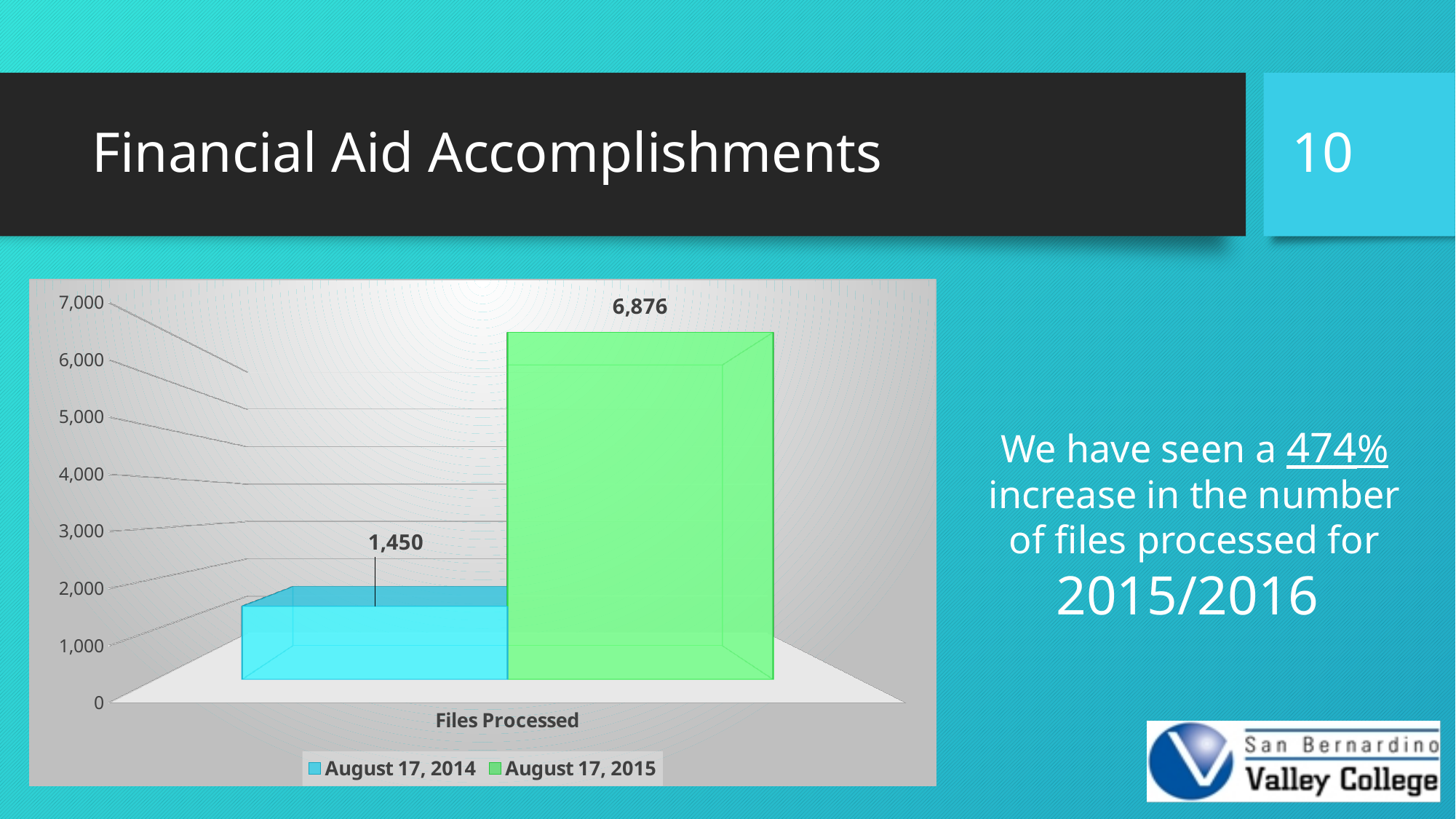
How many series does the legend list? 2 What kind of chart is shown on the slide? bar chart What is the value for August 17, 2014 in the Files Processed chart? 1,450 Is the value for August 17, 2015 greater or less than 6,000? greater What is the category label on the x axis of the chart? Files Processed Which series has the lower value for Files Processed? August 17, 2014 What is the value for August 17, 2015 in the Files Processed chart? 6,876 Is the value for August 17, 2014 greater or less than 2,000? less Which series has the higher value for Files Processed? August 17, 2015 What colour is the bar for August 17, 2015? green Is the value for August 17, 2014 larger or smaller than the value for August 17, 2015? smaller What is the difference between the August 17, 2015 and August 17, 2014 values for Files Processed? 5,426